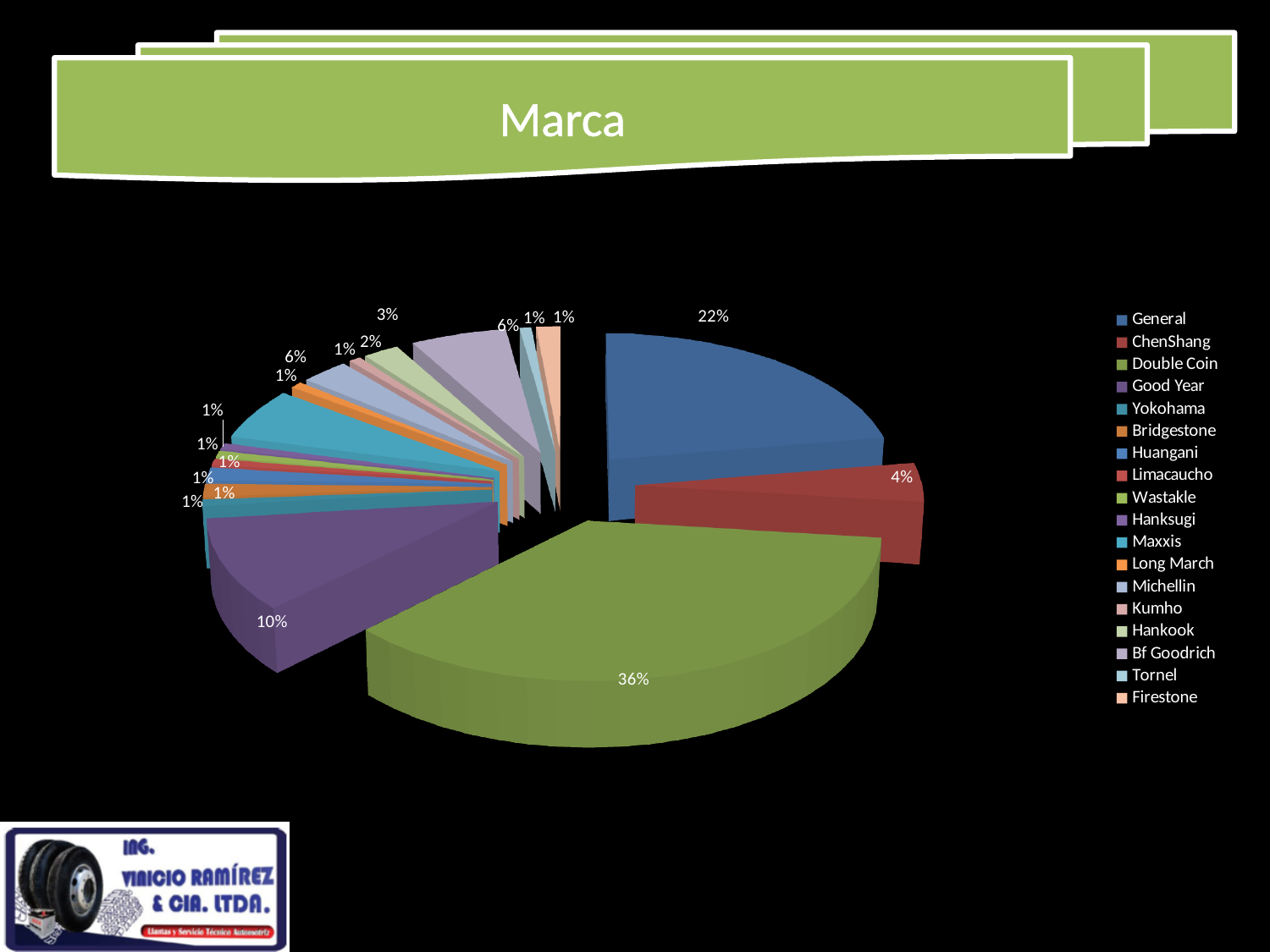
Which brand is listed first in the legend? General What share of the pie does ChenShang have? 4% What is the combined share of General and ChenShang? 26% Which has a larger share, General or Good Year? General What share of the pie does General have? 22% What type of chart is shown on the slide? pie chart What is the title of the chart? Marca What is the difference in percentage points between Double Coin and General? 14 How many brands are listed in the legend? 18 Which brand has the largest slice of the pie? Double Coin What share of the pie does Good Year have? 10% What share of the pie does Double Coin have? 36%